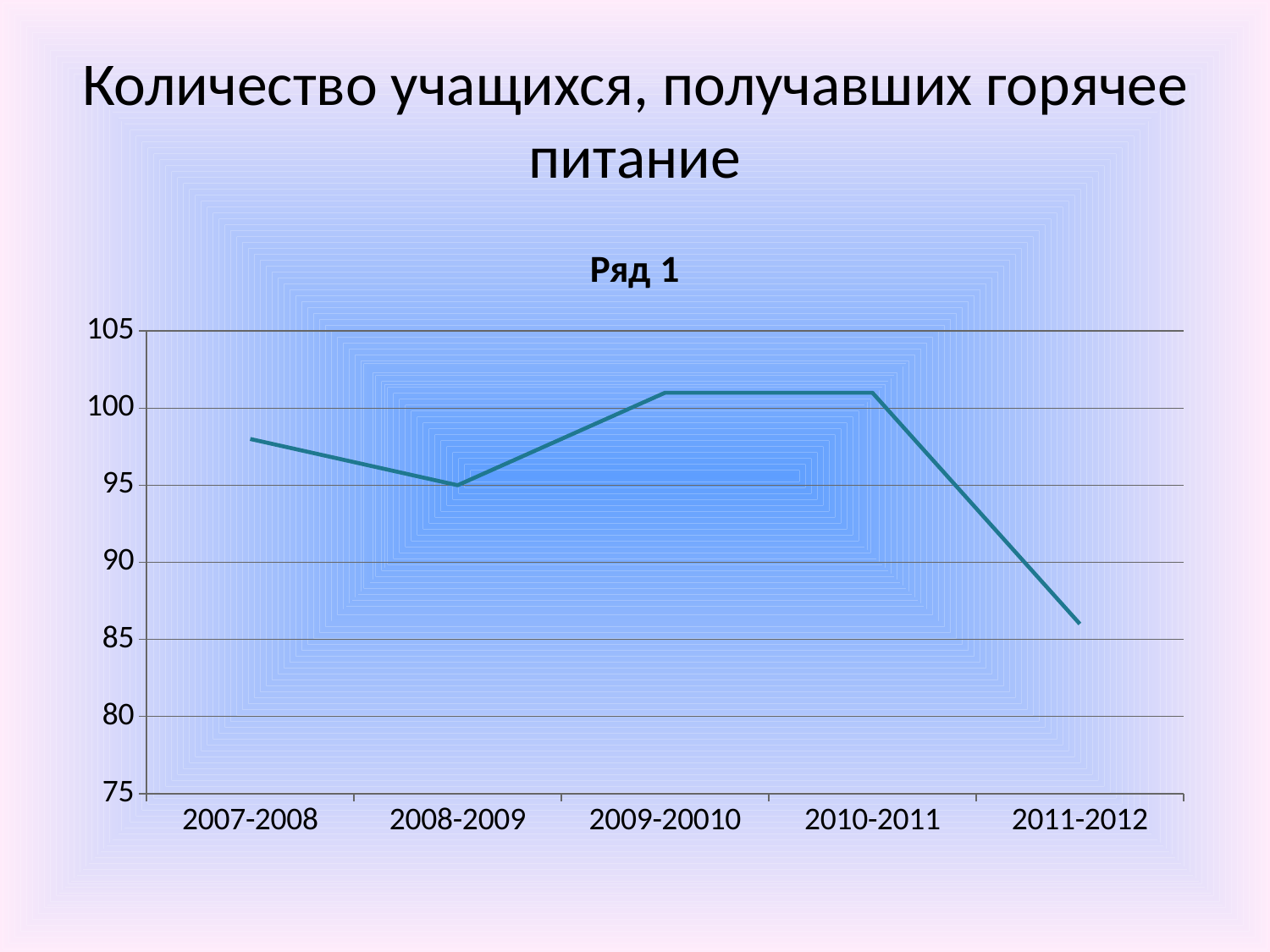
Is the value for 2011-2012 greater or less than 90? less Is the value for 2007-2008 greater or less than 100? less What is the title of the chart? Ряд 1 Which is larger, the value for 2010-2011 or the value for 2011-2012? 2010-2011 Which school year has the lowest value? 2011-2012 Is the value for 2007-2008 greater or less than 95? greater Does the line rise or fall from 2008-2009 to 2009-20010? rise Does the line rise or fall from 2010-2011 to 2011-2012? fall What is the value for 2008-2009? 95 Which is larger, the value for 2007-2008 or the value for 2008-2009? 2007-2008 What kind of chart is shown on the slide? line chart How many school years are plotted on the x axis? 5